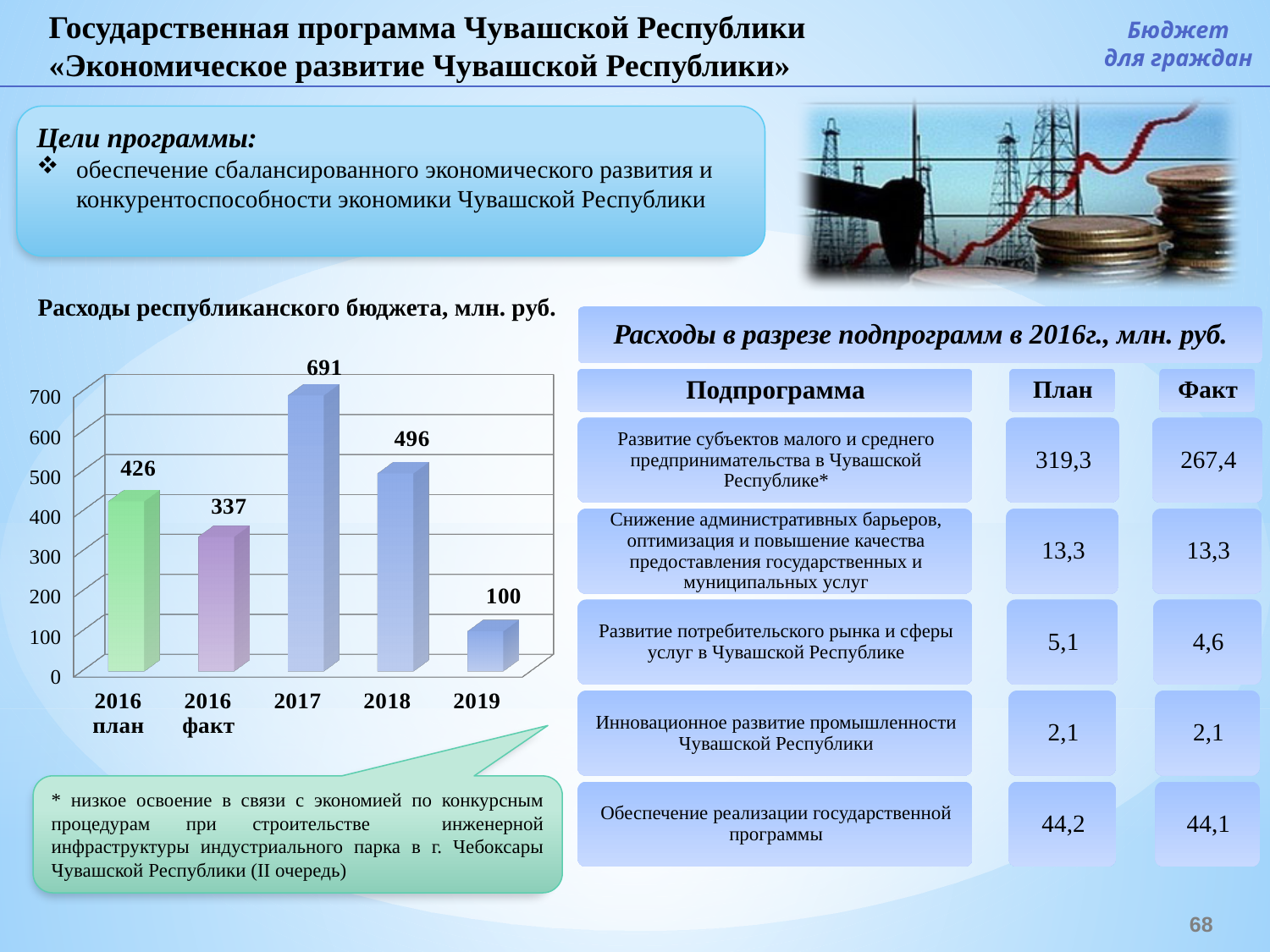
What is the value for 2016 факт in the chart? 337 What is the value for 2017 in the chart "Расходы республиканского бюджета, млн. руб."? 691 What is the title of the chart on the slide? Расходы республиканского бюджета, млн. руб. What kind of chart is shown on the slide? Bar chart What is the value for 2019 in the chart? 100 Which is larger, the value for 2018 or the value for 2016 план? 2018 What is the difference between the values for 2017 and 2018? 195 What is the difference between the values for 2016 план and 2016 факт? 89 Which category has the lowest value in the chart? 2019 How many bars are shown in the chart? 5 Which category has the highest value in the chart? 2017 What is the value for 2016 план in the chart? 426